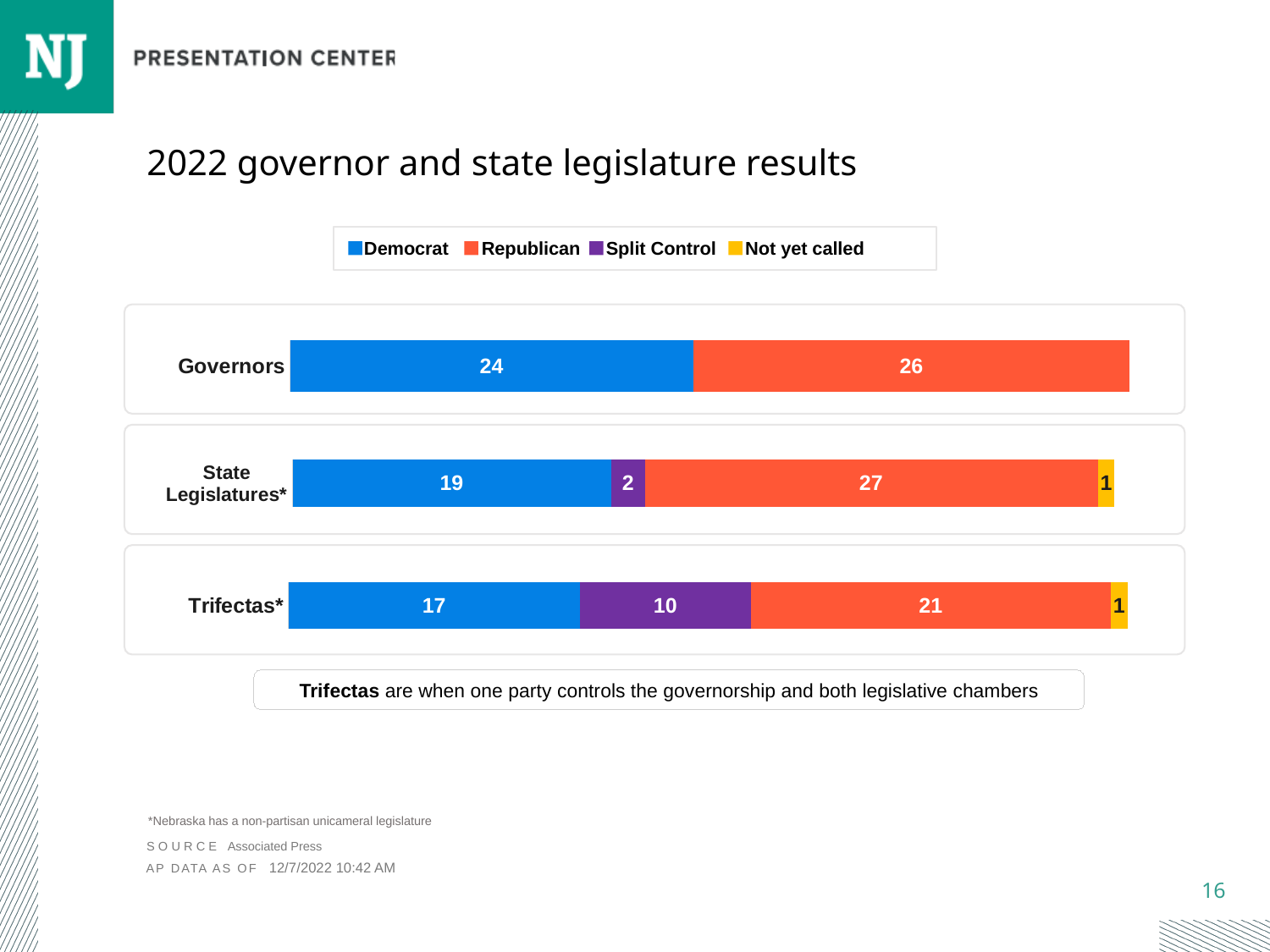
What is the Democrat value for Governors? 24 Which category has the highest Republican value? State Legislatures* What is the Not yet called value for State Legislatures*? 1 Which category has the lowest Democrat value? Trifectas* How many categories are plotted in the chart? 3 What kind of chart is shown on the slide? Stacked bar chart What is the total of the stacked bar for Governors? 50 How many series does the legend list? 4 What is the difference between the Republican and Democrat values for Governors? 2 Which is larger for Trifectas*, the Democrat value or the Republican value? Republican What is the Split Control value for Trifectas*? 10 What is the Republican value for State Legislatures*? 27